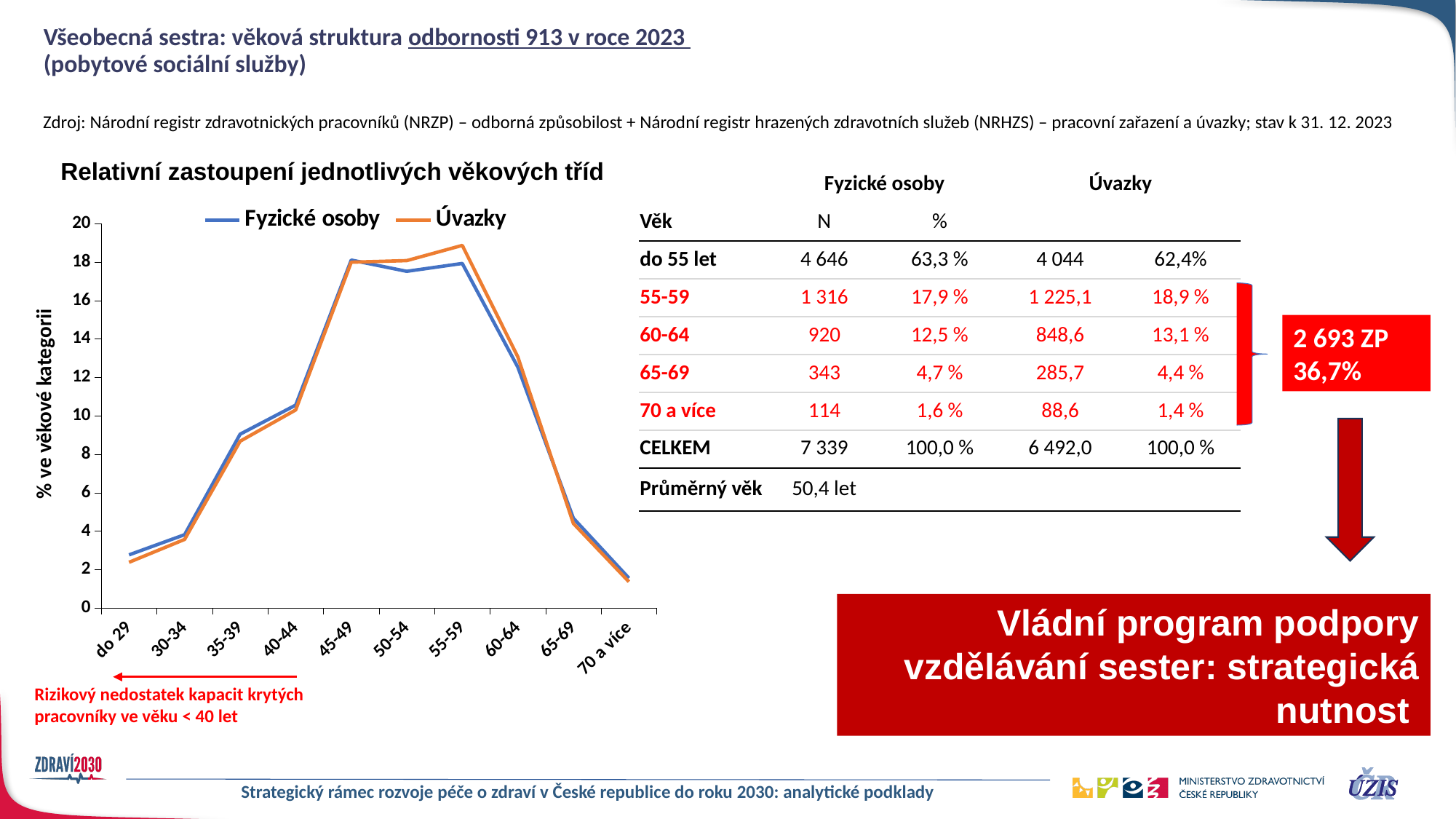
Which age category has the lowest value for Úvazky in the chart? 70 a více Is the value for Fyzické osoby at 65-69 greater or less than 6? less What kind of chart is shown on the slide? line chart Is the value for Fyzické osoby at 60-64 greater or less than 12? greater Which age category has the lowest value for Fyzické osoby in the chart? 70 a více Is the value for Úvazky at 45-49 greater or less than 16? greater Do the values in the chart rise or fall from 45-49 to 70 a více? fall How many series does the chart legend list? 2 What is the title of the chart? Relativní zastoupení jednotlivých věkových tříd At 55-59, which series has the higher value, Fyzické osoby or Úvazky? Úvazky How many age categories are plotted along the x axis of the chart? 10